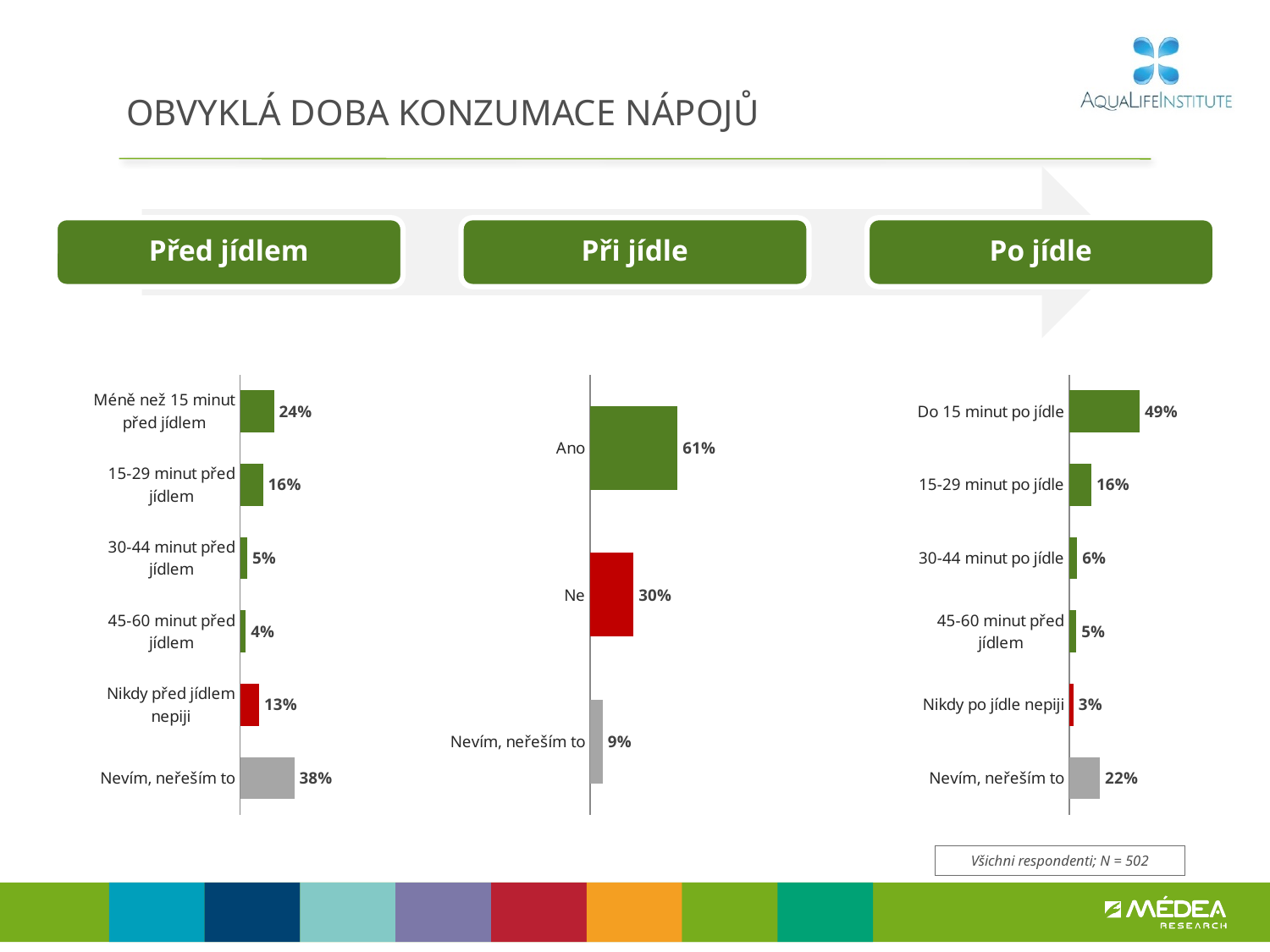
In the 'Při jídle' chart, how many categories are shown? 3 In the 'Před jídlem' chart, which category has the lowest value? 45-60 minut před jídlem In the 'Při jídle' chart, what is the difference between 'Ano' and 'Ne'? 31% In the 'Po jídle' chart, how many categories are shown? 6 In the 'Po jídle' chart, what is the value for 'Do 15 minut po jídle'? 49% What type of chart is the 'Před jídlem' chart? Bar chart In the 'Při jídle' chart, what is the value for 'Ano'? 61% In the 'Po jídle' chart, which category has the lowest value? Nikdy po jídle nepiji In the 'Před jídlem' chart, what is the difference between 'Nevím, neřeším to' and 'Nikdy před jídlem nepiji'? 25% In the 'Před jídlem' chart, what is the value for 'Méně než 15 minut před jídlem'? 24% In the 'Před jídlem' chart, which category has the highest value? Nevím, neřeším to In the 'Po jídle' chart, which is larger: '15-29 minut po jídle' or 'Nevím, neřeším to'? Nevím, neřeším to